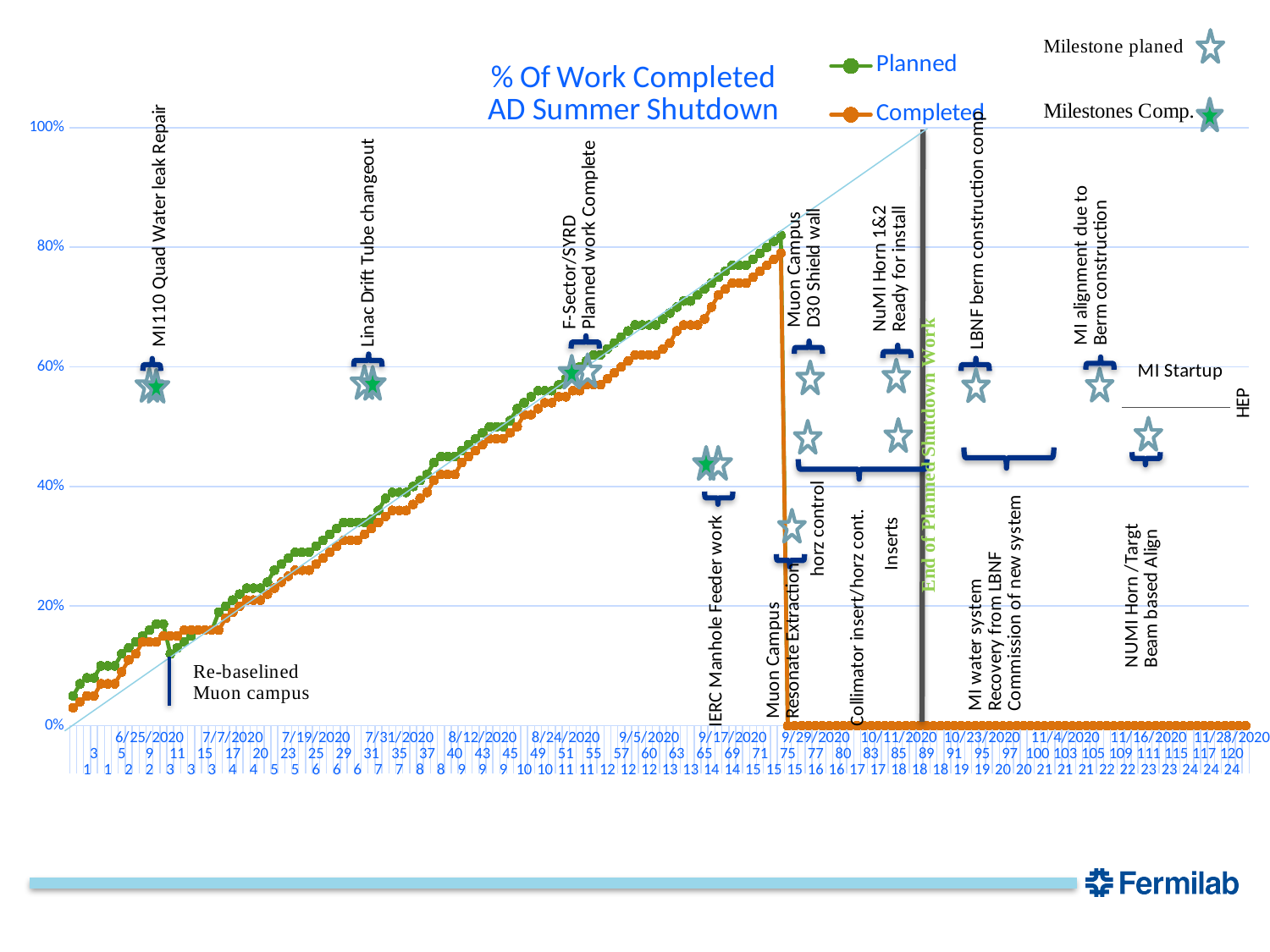
What is the title of the chart? % Of Work Completed AD Summer Shutdown Is the Planned value at 7/31/2020 greater or less than 20%? greater Is the Completed value at 11/4/2020 greater or less than 20%? less Is the Planned value at 8/24/2020 greater or less than 40%? greater What are the two series named in the chart legend? Planned and Completed What kind of chart is shown on the slide? Line chart How many series does the chart legend list? 2 Does the Completed series rise, fall or stay flat from 10/11/2020 to 11/28/2020? Stay flat Does the Planned series rise or fall from 6/25/2020 to 9/29/2020? Rise At 9/17/2020, which series has the higher value, Planned or Completed? Planned